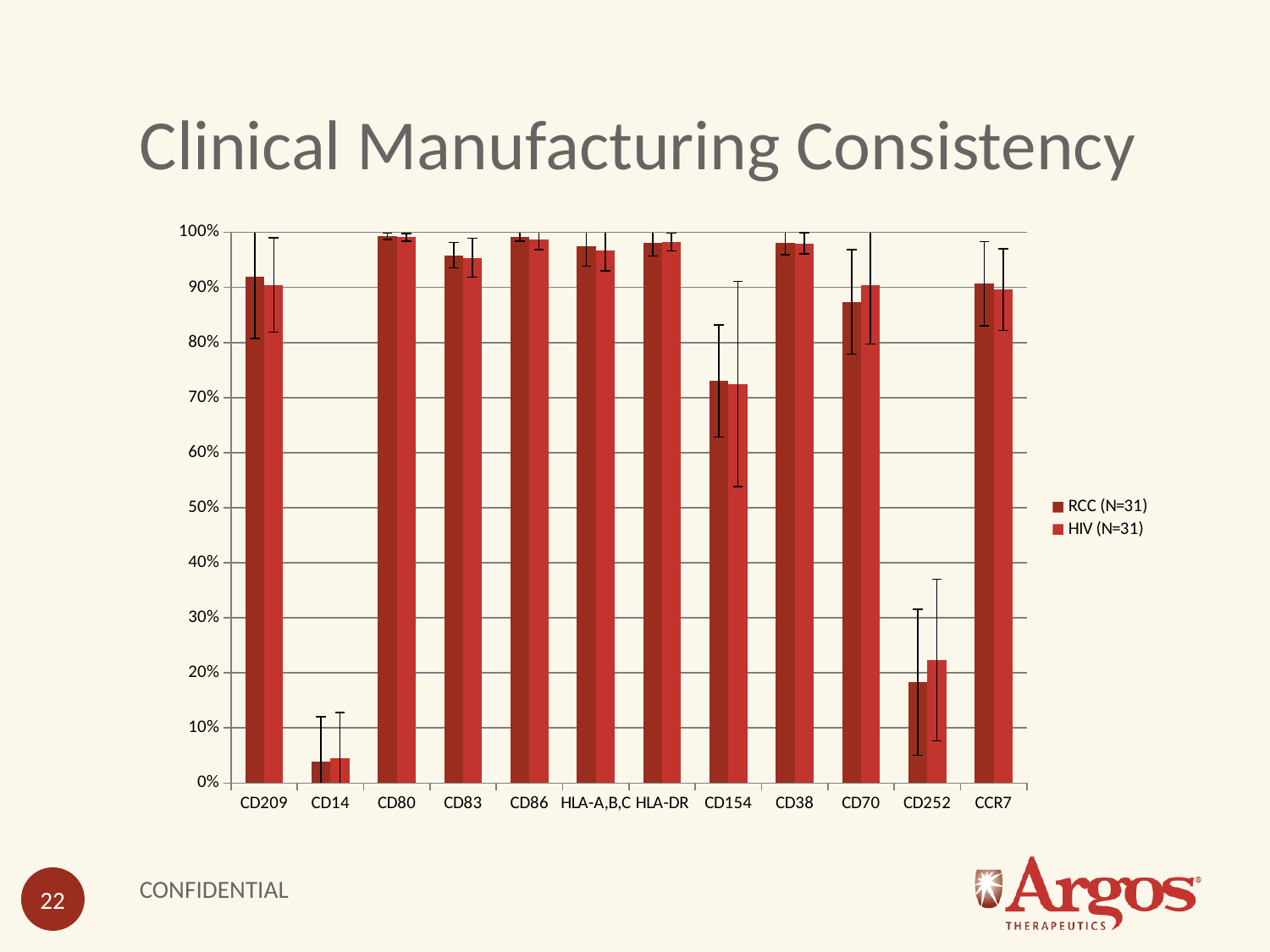
How many series does the legend list? 2 Which is larger, the HIV (N=31) value for CD14 or for CD252? CD252 Is the HIV (N=31) value for CD252 greater or less than 10%? greater Which is larger, the RCC (N=31) value for CD154 or for CD252? CD154 Is the RCC (N=31) value for CD14 greater or less than 10%? less What is the title of the slide containing the chart? Clinical Manufacturing Consistency Which category has the lowest values for both series? CD14 Is the RCC (N=31) value for CD70 greater or less than 90%? less What kind of chart is shown on the slide? bar chart How many categories are shown on the x axis? 12